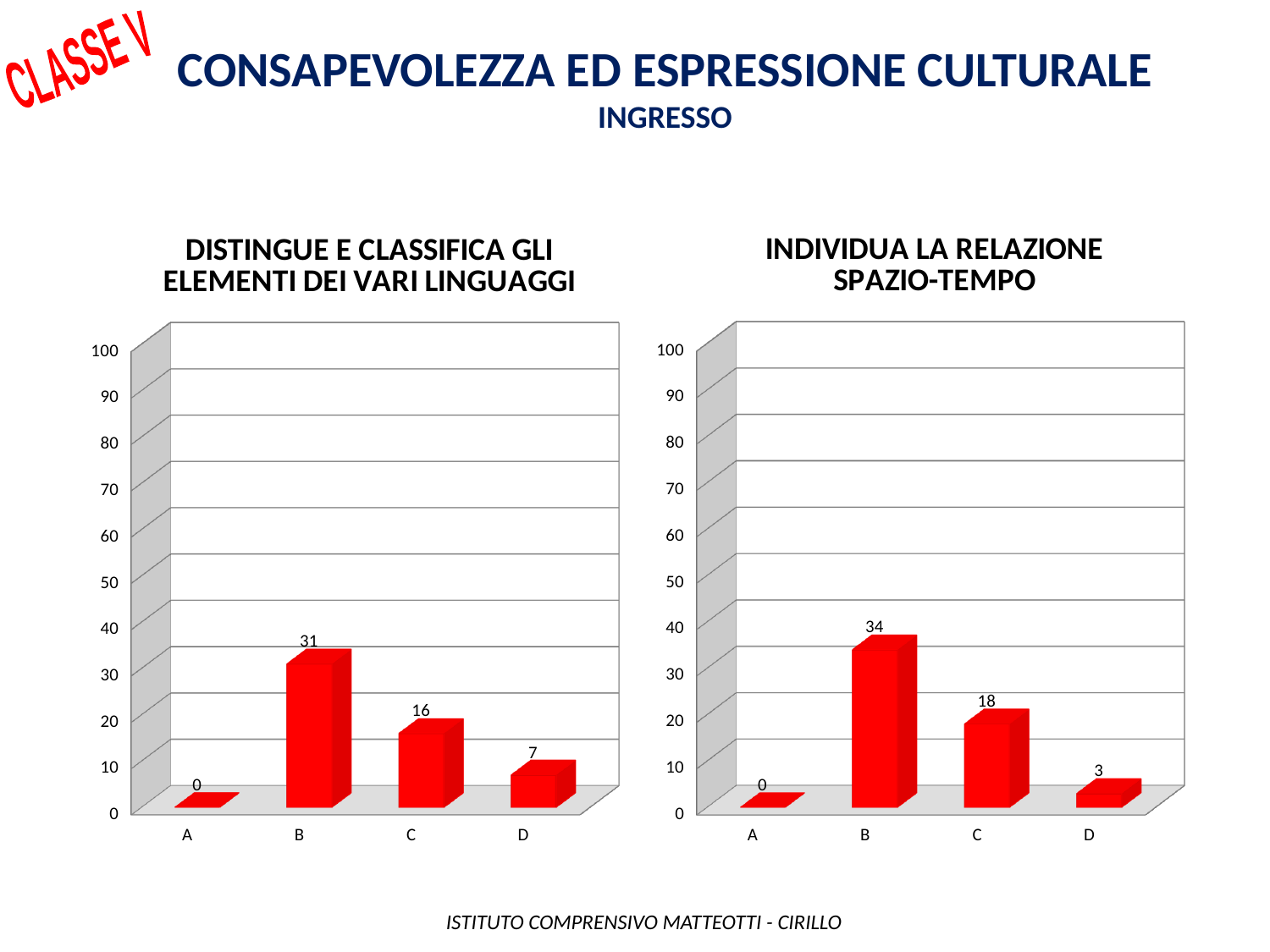
In the chart titled "INDIVIDUA LA RELAZIONE SPAZIO-TEMPO", which category has the lowest value? A What kind of chart is the chart titled "INDIVIDUA LA RELAZIONE SPAZIO-TEMPO"? bar chart How many categories are shown on the x axis of the chart titled "DISTINGUE E CLASSIFICA GLI ELEMENTI DEI VARI LINGUAGGI"? 4 In the chart titled "DISTINGUE E CLASSIFICA GLI ELEMENTI DEI VARI LINGUAGGI", which category has the highest value? B In the chart titled "DISTINGUE E CLASSIFICA GLI ELEMENTI DEI VARI LINGUAGGI", what is the value for category D? 7 In the chart titled "INDIVIDUA LA RELAZIONE SPAZIO-TEMPO", what is the difference between the values for B and C? 16 In the chart titled "DISTINGUE E CLASSIFICA GLI ELEMENTI DEI VARI LINGUAGGI", what is the difference between the values for C and D? 9 In the chart titled "INDIVIDUA LA RELAZIONE SPAZIO-TEMPO", what is the value for category A? 0 Which is larger: the value for B in the left chart or the value for B in the right chart? B in the right chart (34) In the chart titled "INDIVIDUA LA RELAZIONE SPAZIO-TEMPO", is the value for B greater or less than 30? greater In the chart titled "INDIVIDUA LA RELAZIONE SPAZIO-TEMPO", what is the value for category C? 18 In the chart titled "DISTINGUE E CLASSIFICA GLI ELEMENTI DEI VARI LINGUAGGI", what is the value for category B? 31